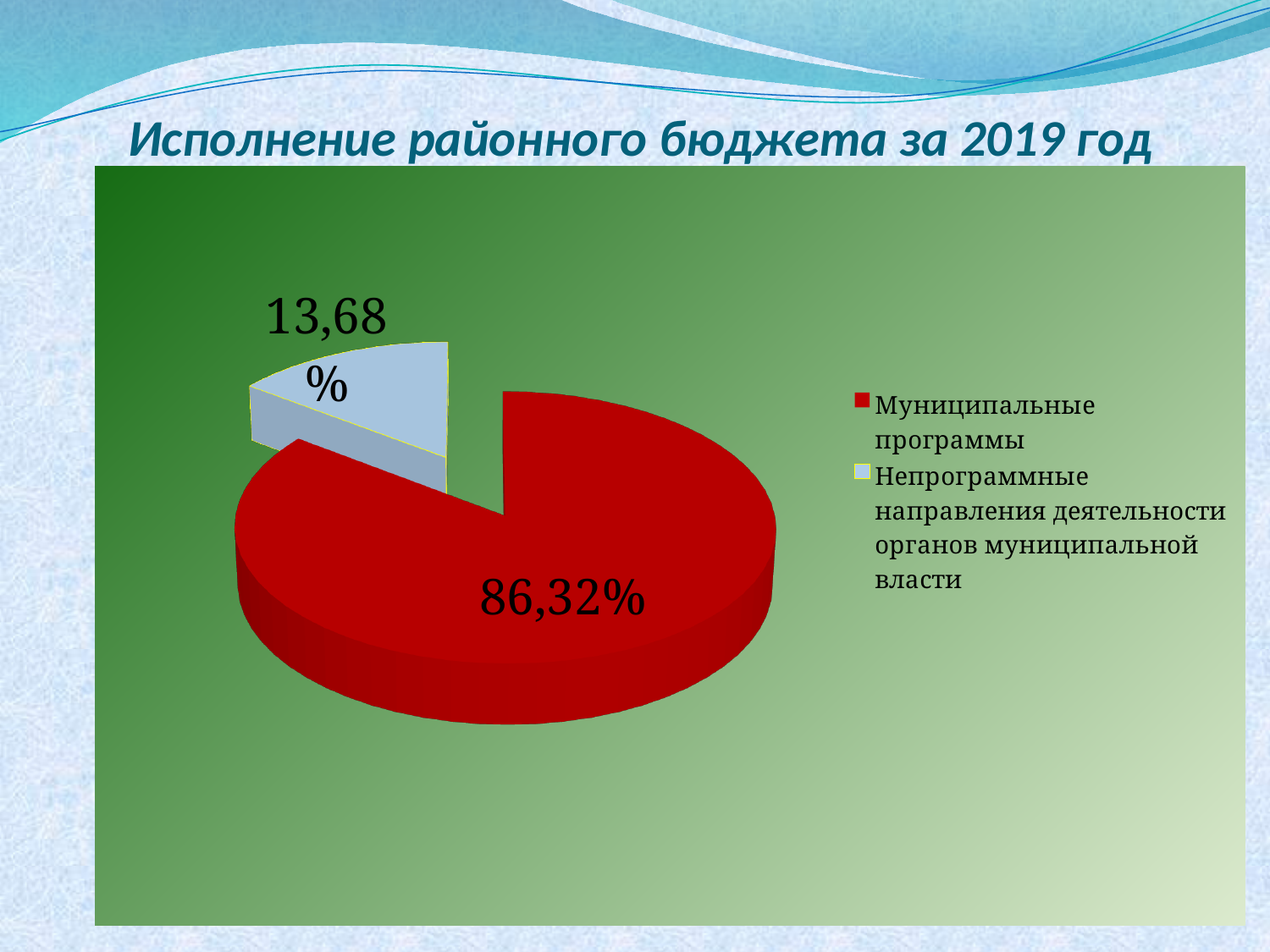
Which category has the smallest slice of the pie? Непрограммные направления деятельности органов муниципальной власти What is the title of the slide containing the chart? Исполнение районного бюджета за 2019 год How many slices does the pie chart have? 2 How many entries does the legend list? 2 What kind of chart is shown on the slide? Pie chart What is the value for Непрограммные направления деятельности органов муниципальной власти? 13,68% What is the difference in percentage points between Муниципальные программы and Непрограммные направления деятельности органов муниципальной власти? 72,64 Which category has the largest slice of the pie? Муниципальные программы What is the value for Муниципальные программы? 86,32% Which is larger: the share for Муниципальные программы or the share for Непрограммные направления деятельности органов муниципальной власти? Муниципальные программы What colour is the slice for Муниципальные программы? Red